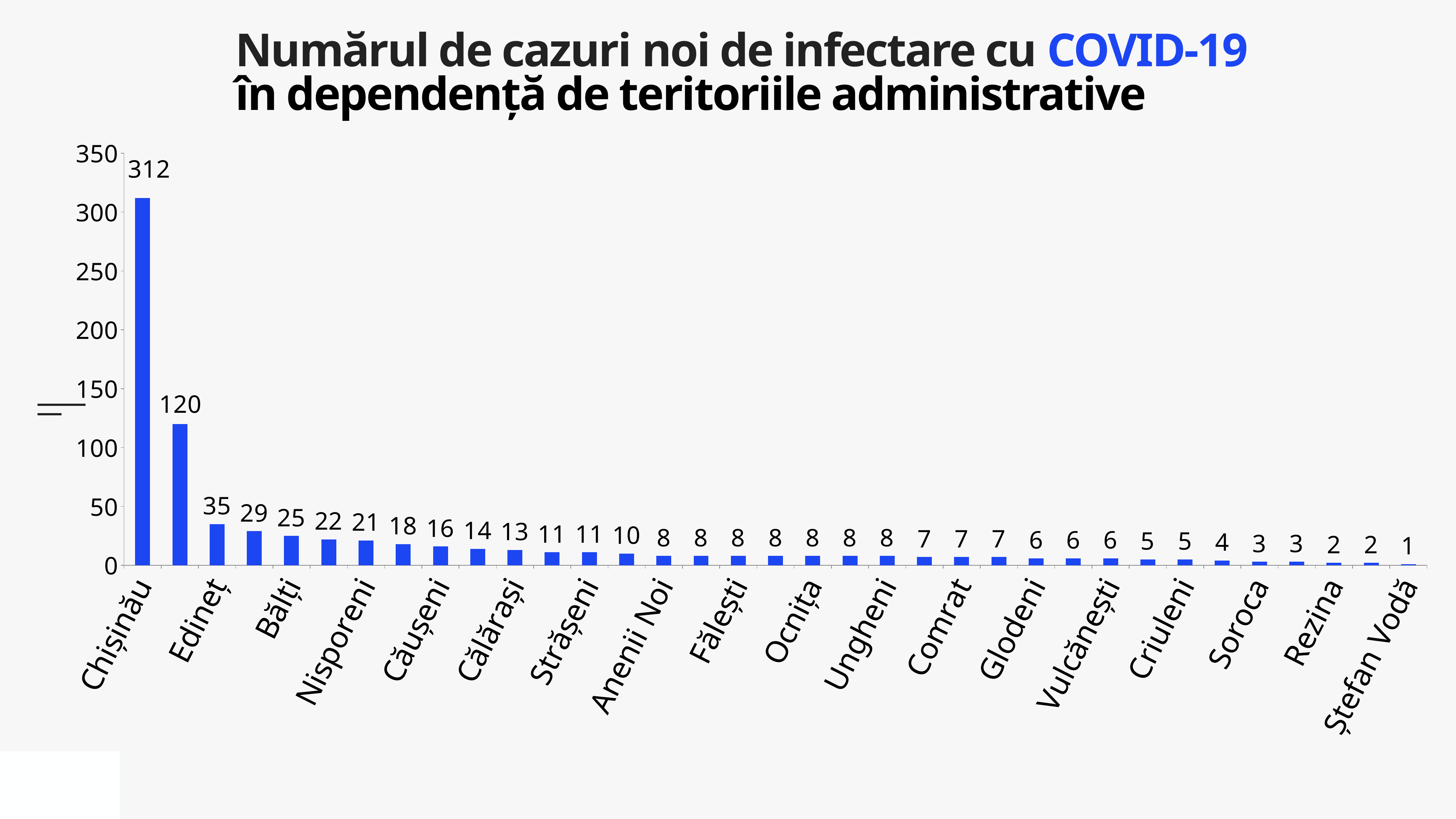
Is the value for Chișinău greater or less than 300? greater Which administrative territory has the lowest number of new cases? Ștefan Vodă What is the number of new cases for Ștefan Vodă? 1 What type of chart is shown on the slide? bar chart What is the value of the second-highest bar in the chart? 120 What is the highest value shown on the vertical axis? 350 What is the number of new cases for Chișinău? 312 What is the difference between the number of cases in Chișinău and in Ștefan Vodă? 311 Which has more new cases, Chișinău or Edineț? Chișinău Do the values rise or fall from left to right along the x axis? fall Which administrative territory has the highest number of new COVID-19 cases? Chișinău What colour are the bars in the chart? blue